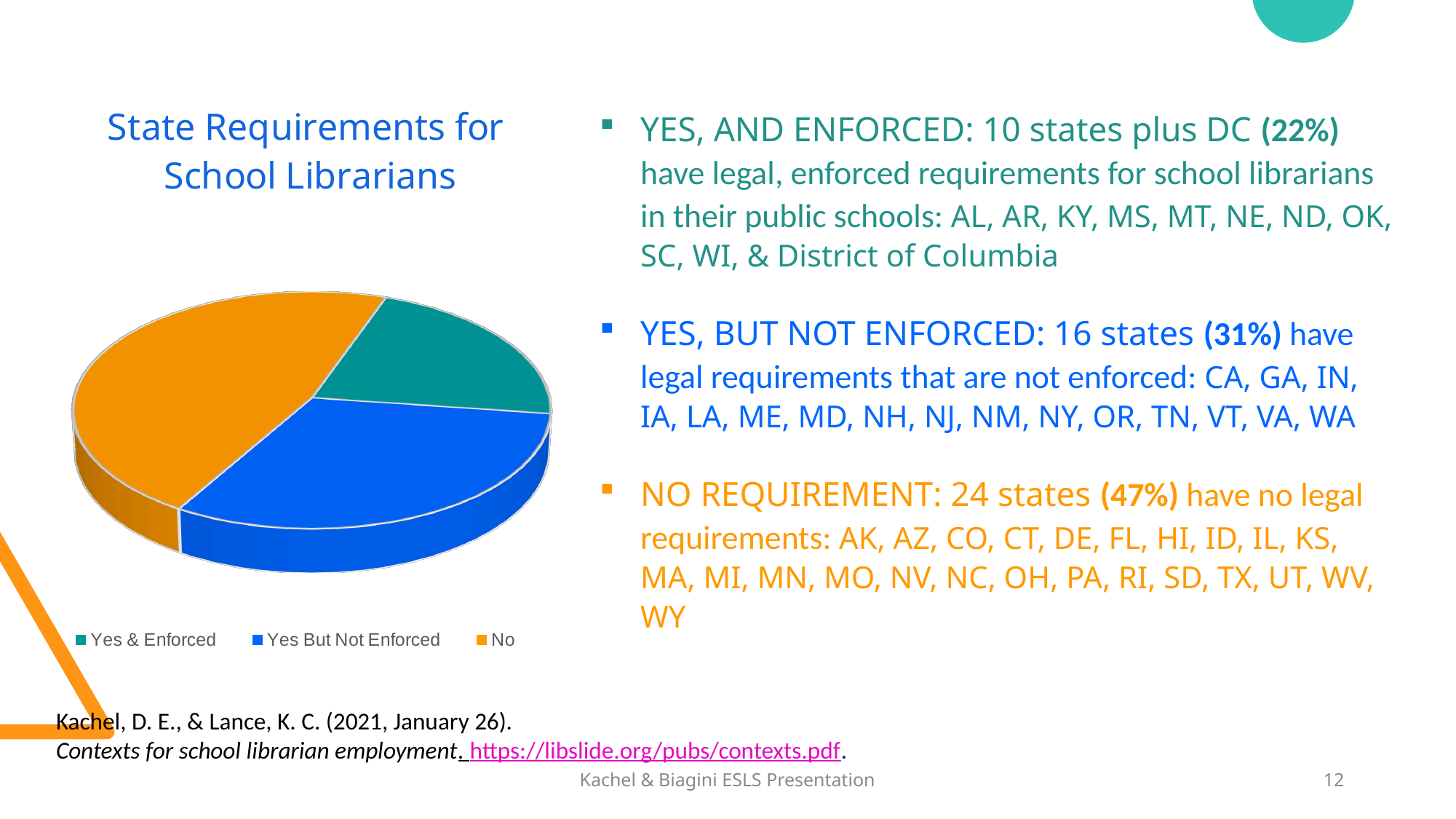
What share of the pie does the No category represent? 47% What share of the pie does the Yes But Not Enforced category represent? 31% Which slice is larger: Yes But Not Enforced or Yes & Enforced? Yes But Not Enforced How many slices does the pie chart have? 3 What is the title of the pie chart? State Requirements for School Librarians What share of the pie does the Yes & Enforced category represent? 22% Which slice is larger: No or Yes But Not Enforced? No What kind of chart is shown on the slide? pie chart Which category has the smallest slice of the pie chart? Yes & Enforced What colour is the No slice in the pie chart? orange Which category has the largest slice of the pie chart? No